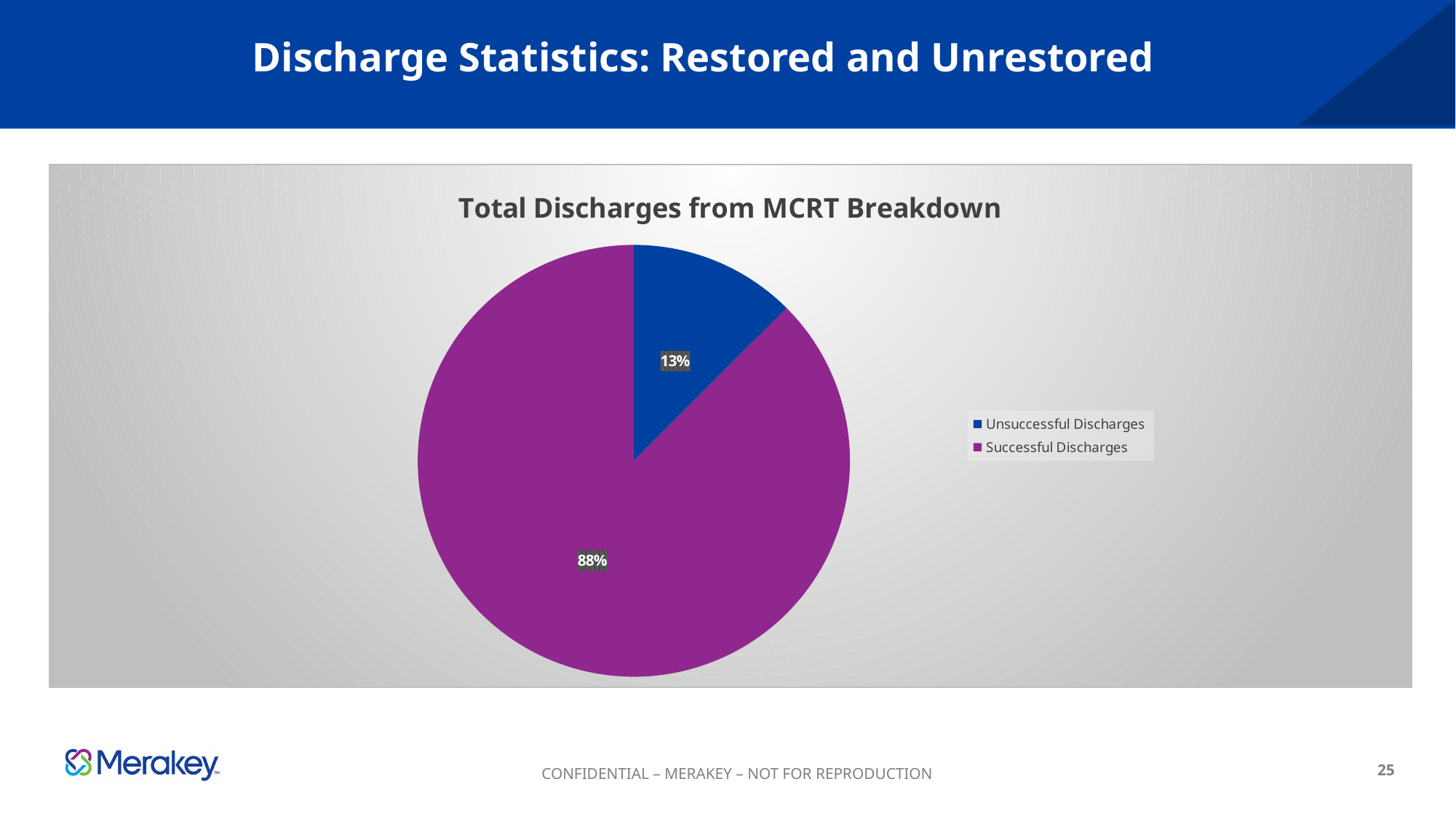
What is the difference in percentage points between Successful Discharges and Unsuccessful Discharges? 75 What share of the pie is Unsuccessful Discharges? 13% Which category has the smallest slice of the pie? Unsuccessful Discharges Which is larger, Successful Discharges or Unsuccessful Discharges? Successful Discharges What colour is the Successful Discharges slice? Purple Which category has the largest slice of the pie? Successful Discharges What is the title of the chart? Total Discharges from MCRT Breakdown What share of the pie is Successful Discharges? 88% How many entries does the legend list? 2 What kind of chart is shown on the slide? Pie chart How many categories does the pie chart show? 2